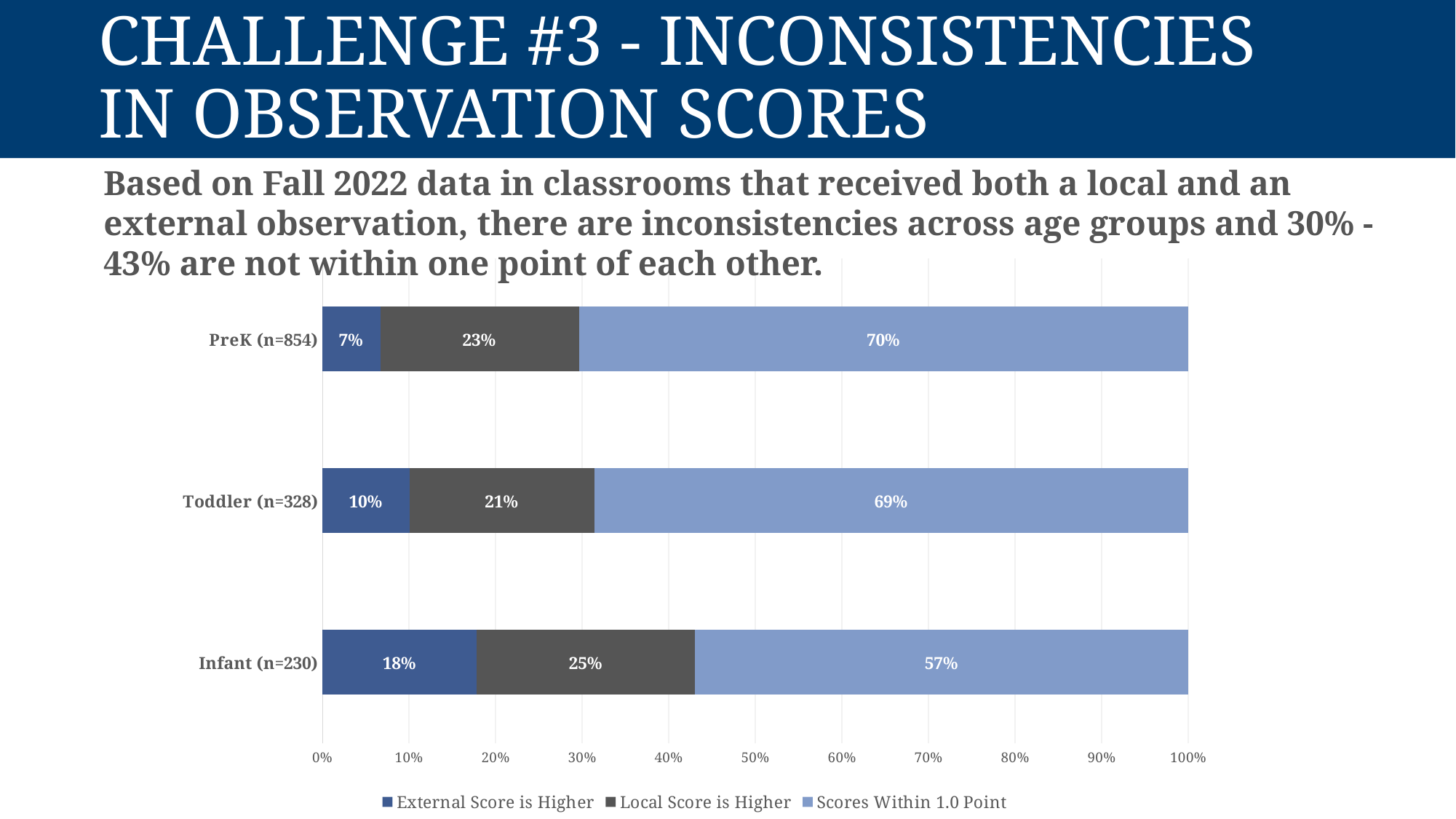
How many age groups are shown in the chart? 3 What is the value for External Score is Higher in the Infant (n=230) group? 18% How many series does the legend list? 3 Which age group has the highest value for External Score is Higher? Infant (n=230) What is the total of the stacked bar for Toddler (n=328)? 100% What percentage of PreK (n=854) classrooms had Scores Within 1.0 Point? 70% Which series is shown in the light blue colour in the chart? Scores Within 1.0 Point What kind of chart is shown on the slide? Stacked bar chart Which is larger: Local Score is Higher for Infant (n=230) or for PreK (n=854)? Infant (n=230) What is the difference between the Scores Within 1.0 Point values for PreK (n=854) and Infant (n=230)? 13% Which age group has the lowest value for Scores Within 1.0 Point? Infant (n=230) What is the value for Local Score is Higher in the Toddler (n=328) group? 21%